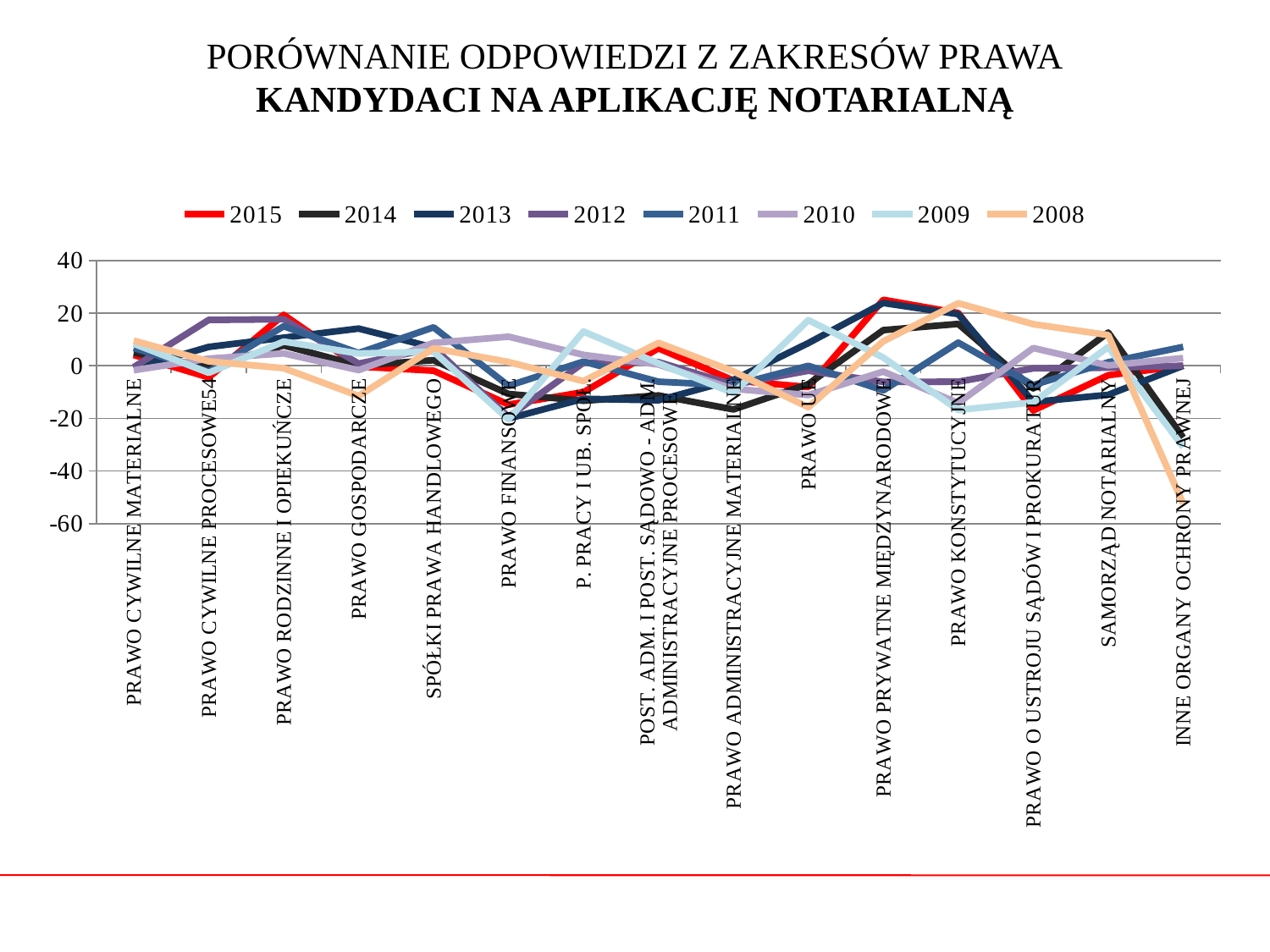
Is the value of the 2008 series for PRAWO KONSTYTUCYJNE greater or less than 20? greater For INNE ORGANY OCHRONY PRAWNEJ, which series has the larger value, 2008 or 2013? 2013 Is the value of the 2008 series for INNE ORGANY OCHRONY PRAWNEJ greater or less than -40? less What kind of chart is shown on the slide? line chart Is the value of the 2015 series for PRAWO PRYWATNE MIĘDZYNARODOWE greater or less than 20? greater Which series is drawn in red? 2015 For PRAWO KONSTYTUCYJNE, which series has the larger value, 2008 or 2009? 2008 For which category does the 2008 series reach its highest value? PRAWO KONSTYTUCYJNE How many series does the legend list? 8 How many categories are plotted along the x axis? 15 For which category does the 2008 series reach its lowest value? INNE ORGANY OCHRONY PRAWNEJ